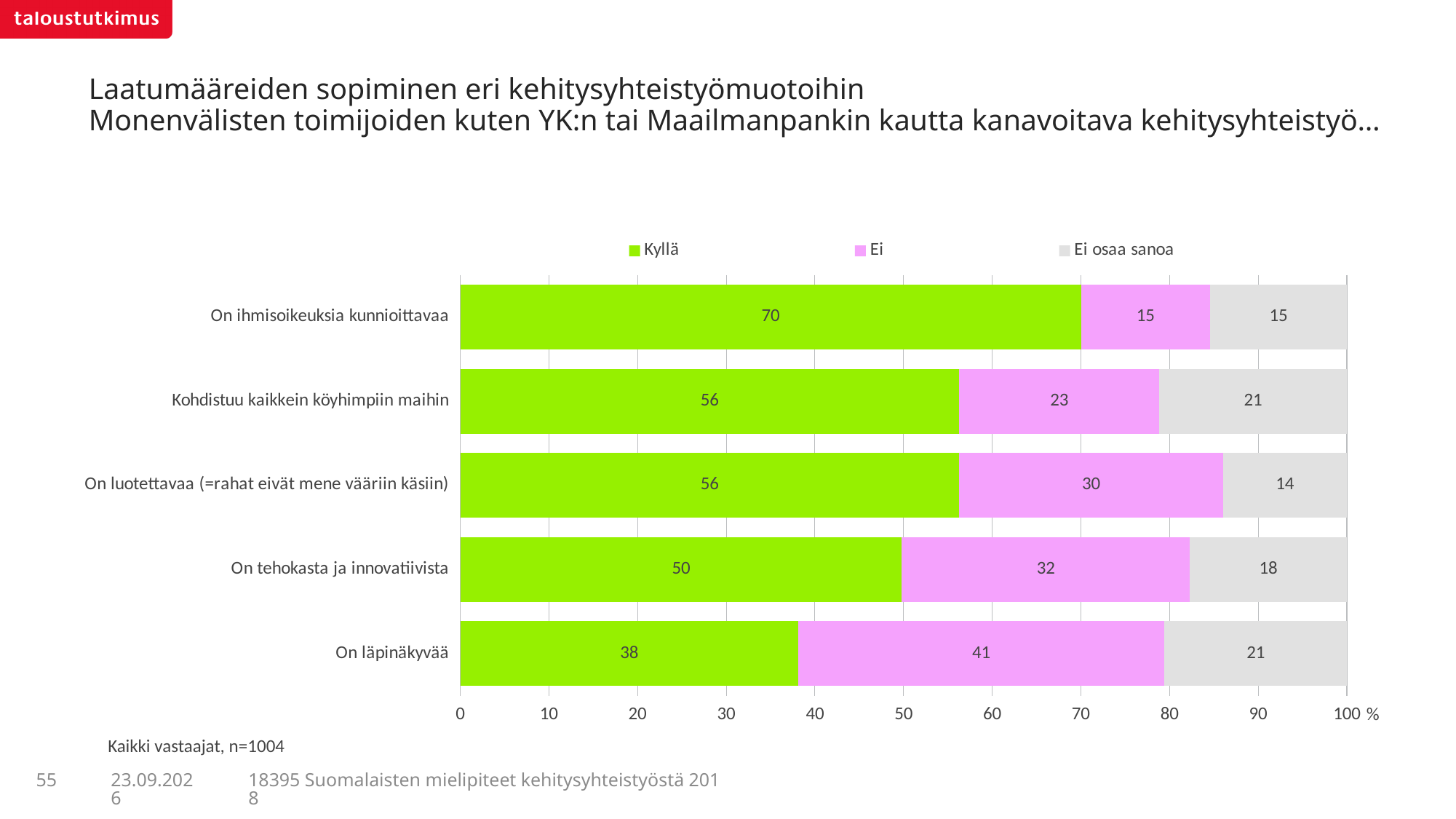
What kind of chart is shown on the slide? Stacked bar chart What is the "Ei" value for "On läpinäkyvää"? 41 How many series does the legend list? 3 What is the "Ei osaa sanoa" value for "On luotettavaa (=rahat eivät mene vääriin käsiin)"? 14 What is the difference between the "Kyllä" values for "On ihmisoikeuksia kunnioittavaa" and "On tehokasta ja innovatiivista"? 20 Which category has the lowest "Kyllä" value? On läpinäkyvää How many categories are shown in the chart? 5 Which is larger: the "Ei" value for "Kohdistuu kaikkein köyhimpiin maihin" or the "Ei" value for "On tehokasta ja innovatiivista"? On tehokasta ja innovatiivista Which category has the highest "Kyllä" value? On ihmisoikeuksia kunnioittavaa What is the "Kyllä" value for "On ihmisoikeuksia kunnioittavaa"? 70 Which category has the highest "Ei" value? On läpinäkyvää What is the total of the stacked bar for "On tehokasta ja innovatiivista"? 100